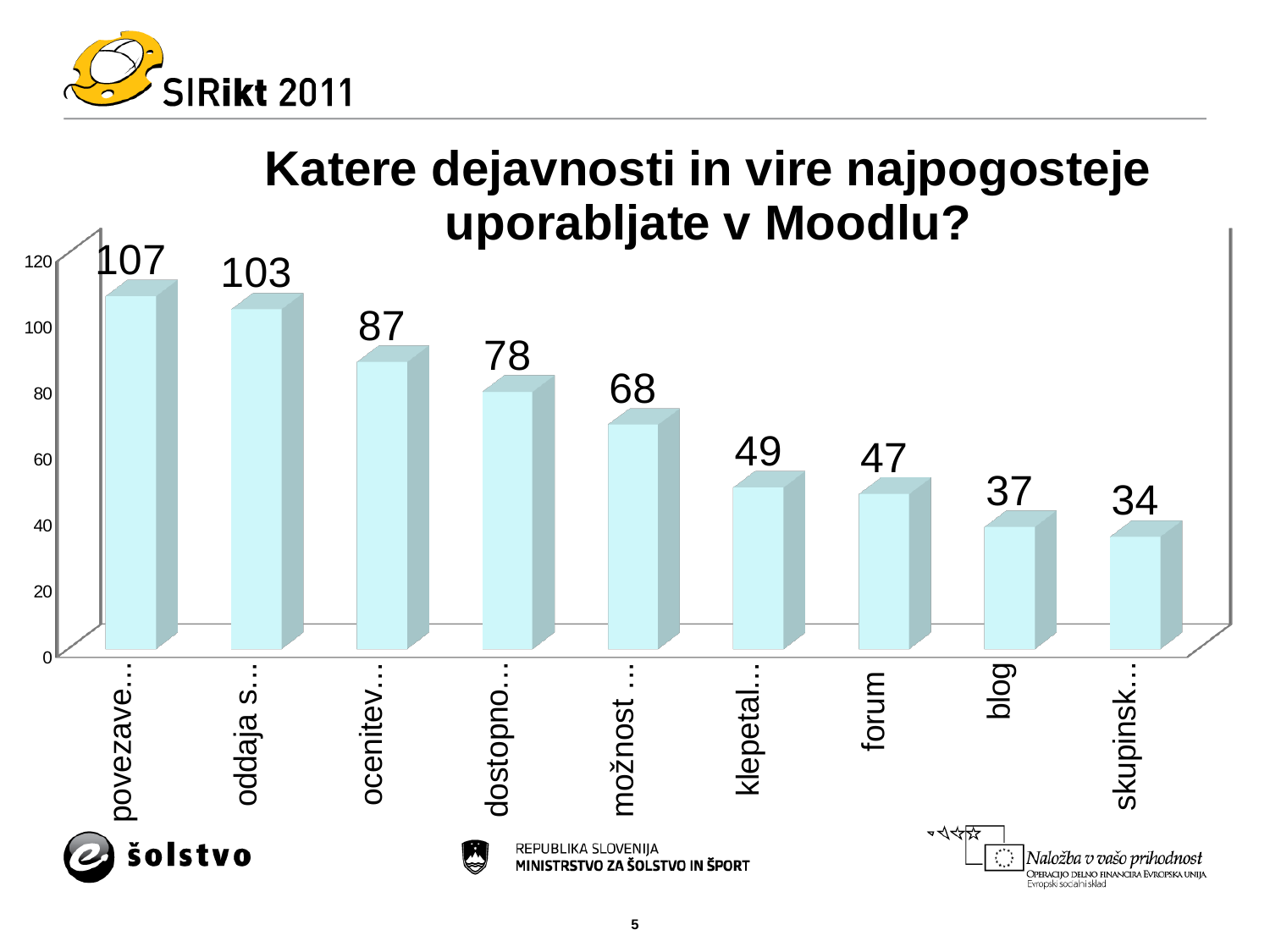
What is the title of the chart? Katere dejavnosti in vire najpogosteje uporabljate v Moodlu? How many bars are plotted in the chart? 9 Which has a larger value, forum or blog? forum What is the difference between the values for forum and blog? 10 What is the highest value shown in the chart? 107 What is the value for blog? 37 What is the value of the last (rightmost) bar in the chart? 34 What is the value of the first (leftmost) bar in the chart? 107 Do the bar values rise or fall from left to right along the x axis? fall What type of chart is shown on the slide? bar chart What is the value for forum? 47 Which category has the lowest value in the chart? skupinsk...